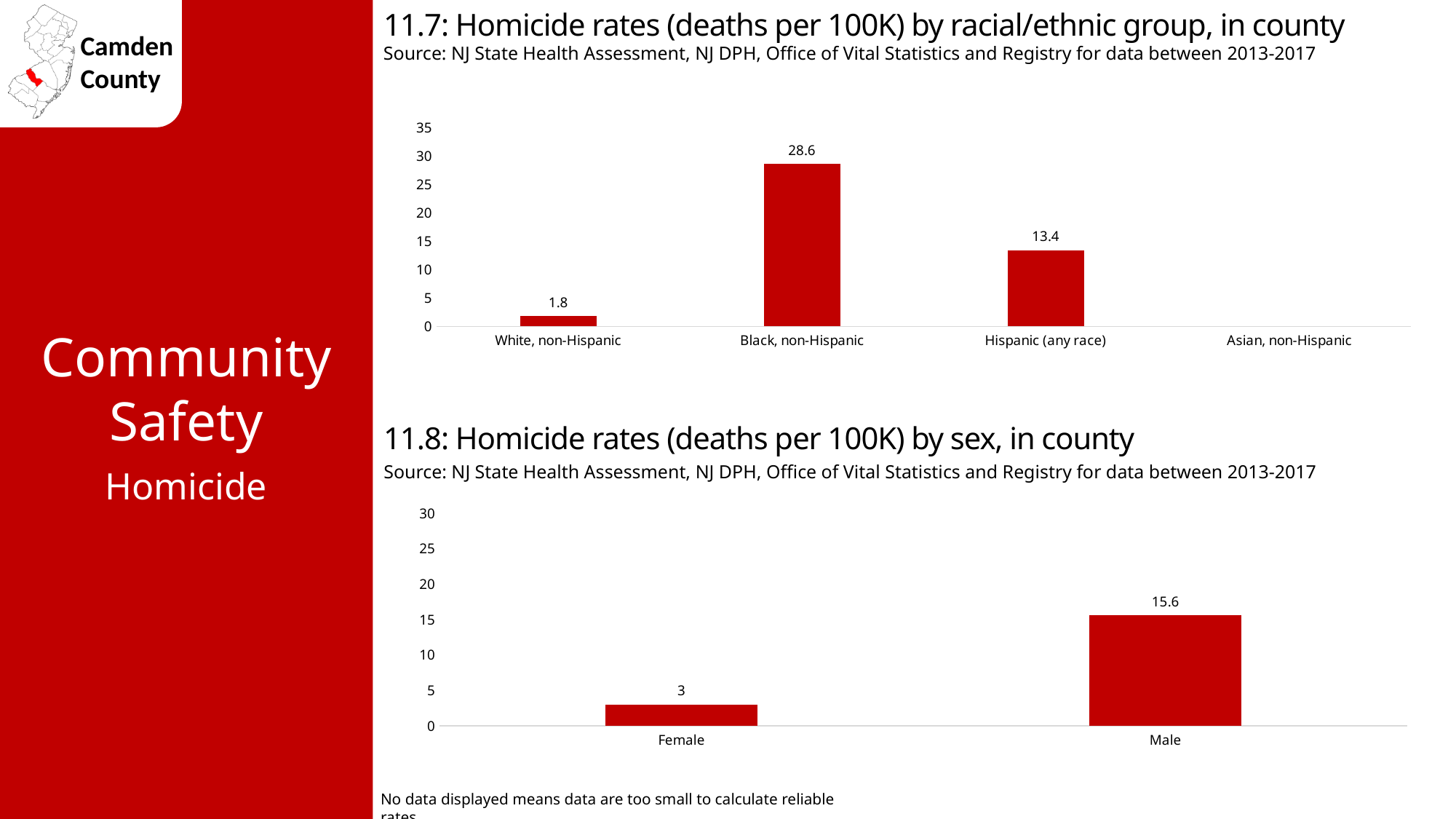
What kind of chart is '11.8: Homicide rates (deaths per 100K) by sex, in county'? Bar chart In the chart '11.7: Homicide rates (deaths per 100K) by racial/ethnic group, in county', what is the difference between the Black, non-Hispanic and Hispanic (any race) rates? 15.2 In the chart '11.8: Homicide rates (deaths per 100K) by sex, in county', what is the value for Female? 3 In the chart '11.7: Homicide rates (deaths per 100K) by racial/ethnic group, in county', which category has no bar displayed? Asian, non-Hispanic In the chart '11.7: Homicide rates (deaths per 100K) by racial/ethnic group, in county', what is the value for White, non-Hispanic? 1.8 In the chart '11.7: Homicide rates (deaths per 100K) by racial/ethnic group, in county', what is the value for Black, non-Hispanic? 28.6 In the chart '11.7: Homicide rates (deaths per 100K) by racial/ethnic group, in county', what is the value for Hispanic (any race)? 13.4 In the chart '11.8: Homicide rates (deaths per 100K) by sex, in county', which sex has the higher homicide rate? Male In the chart '11.7: Homicide rates (deaths per 100K) by racial/ethnic group, in county', which group has the highest homicide rate? Black, non-Hispanic In the chart '11.8: Homicide rates (deaths per 100K) by sex, in county', what is the value for Male? 15.6 In the chart '11.8: Homicide rates (deaths per 100K) by sex, in county', what is the difference between the Male and Female rates? 12.6 In the chart '11.7: Homicide rates (deaths per 100K) by racial/ethnic group, in county', how many category labels are shown on the x axis? 4